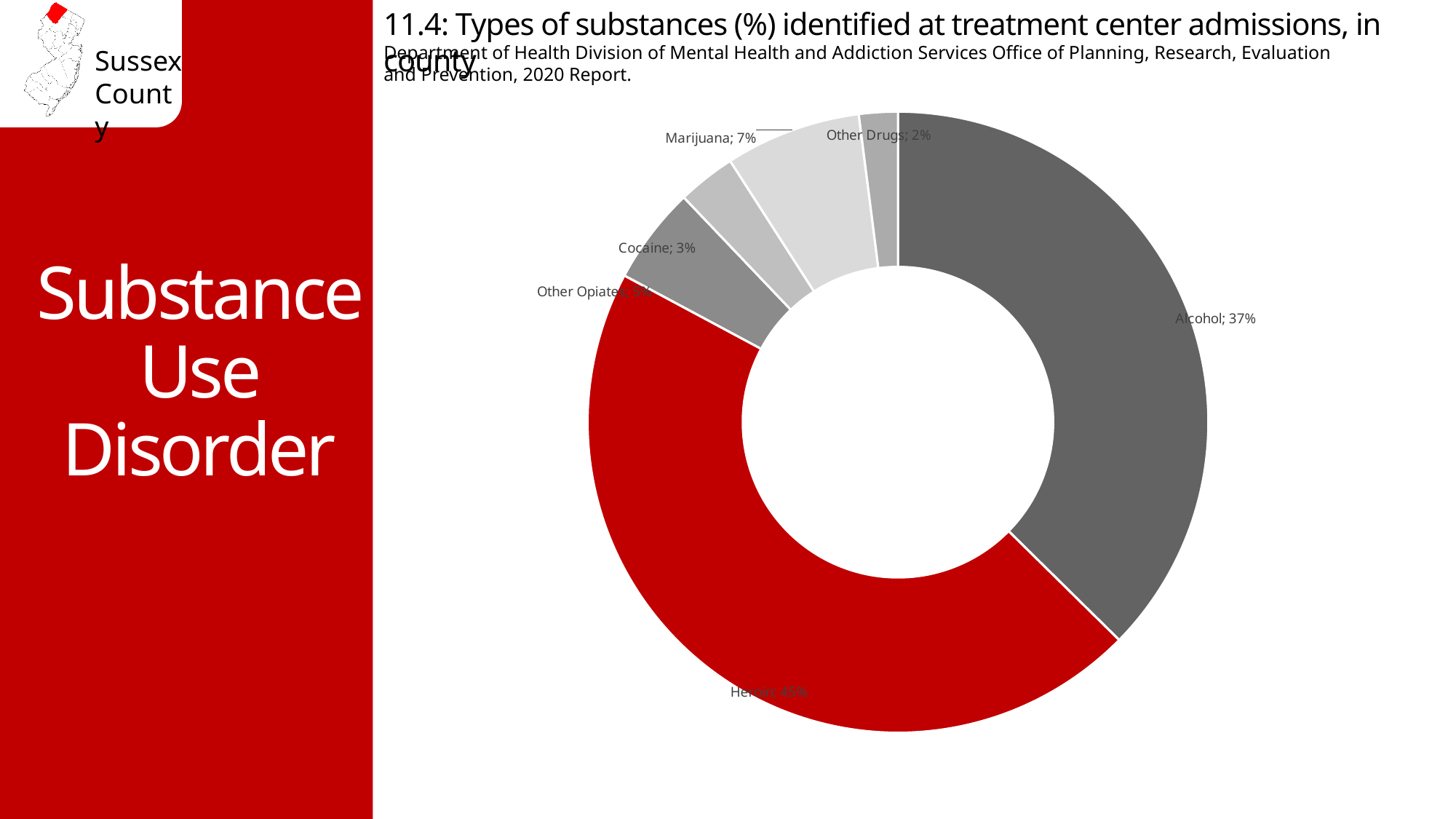
Which substance has the largest share of admissions? Heroin How many percentage points higher is Alcohol than Marijuana? 30 percentage points How many substance categories are shown in the chart? 6 What percentage is shown for Other Drugs? 2% Which substance has the smallest share of admissions? Other Drugs What percentage is shown for Heroin? 45% What percentage of treatment center admissions identified Alcohol? 37% What percentage is shown for Marijuana? 7% What type of chart is used on this slide? Doughnut (pie) chart How many percentage points higher is Heroin than Alcohol? 8 percentage points Which has a larger share, Marijuana or Cocaine? Marijuana What percentage is shown for Cocaine? 3%